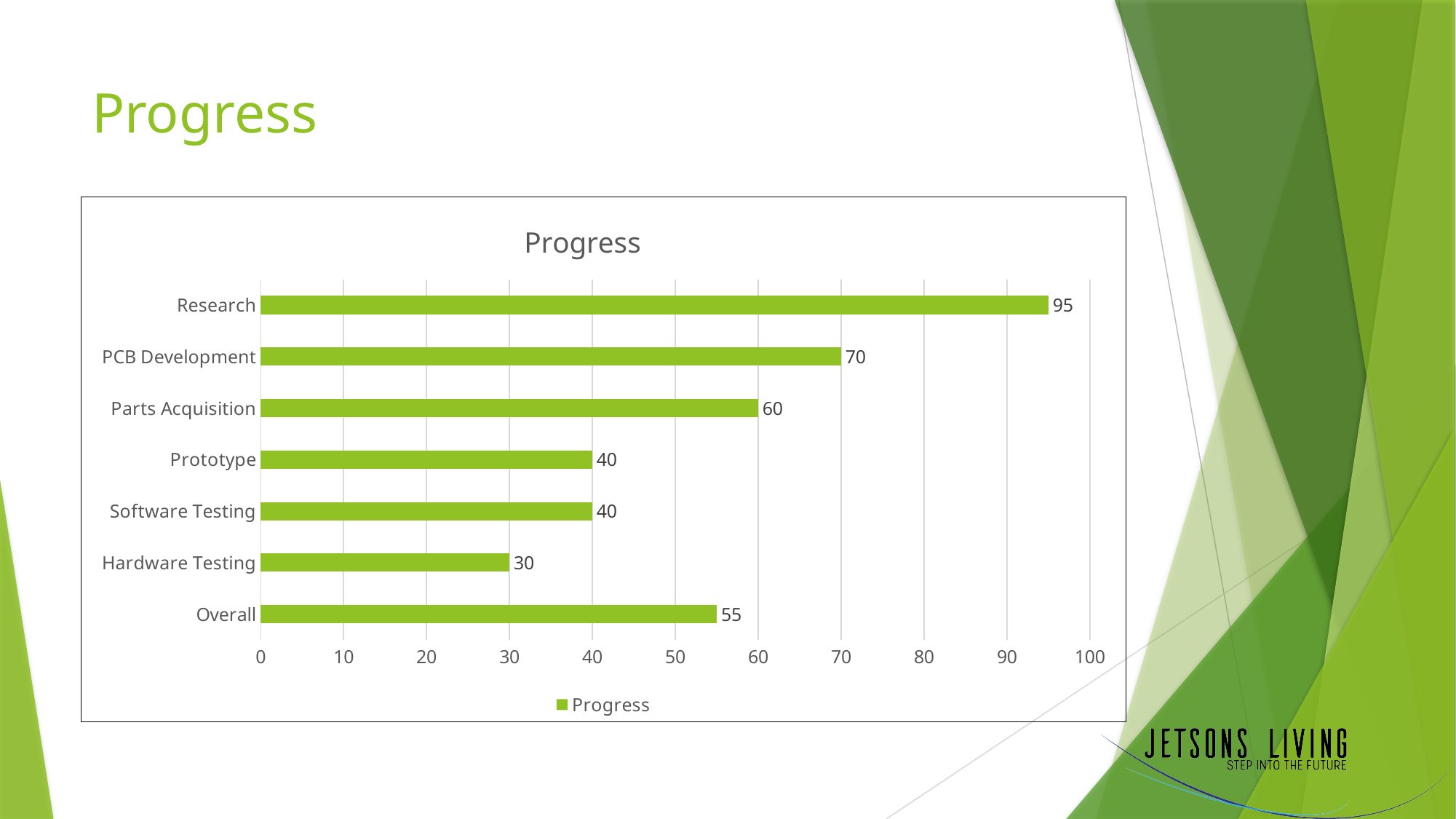
What is the value for PCB Development? 70 What is the difference between the values for Research and PCB Development? 25 Which category has the highest value? Research What is the title of the chart? Progress How many categories are shown in the chart? 7 What is the difference between the values for Parts Acquisition and Hardware Testing? 30 What kind of chart is shown on the slide? Bar chart Which category has the lowest value? Hardware Testing What is the value for Hardware Testing? 30 Which is larger, the value for Parts Acquisition or the value for Overall? Parts Acquisition What is the value for Overall? 55 What is the value for Research? 95